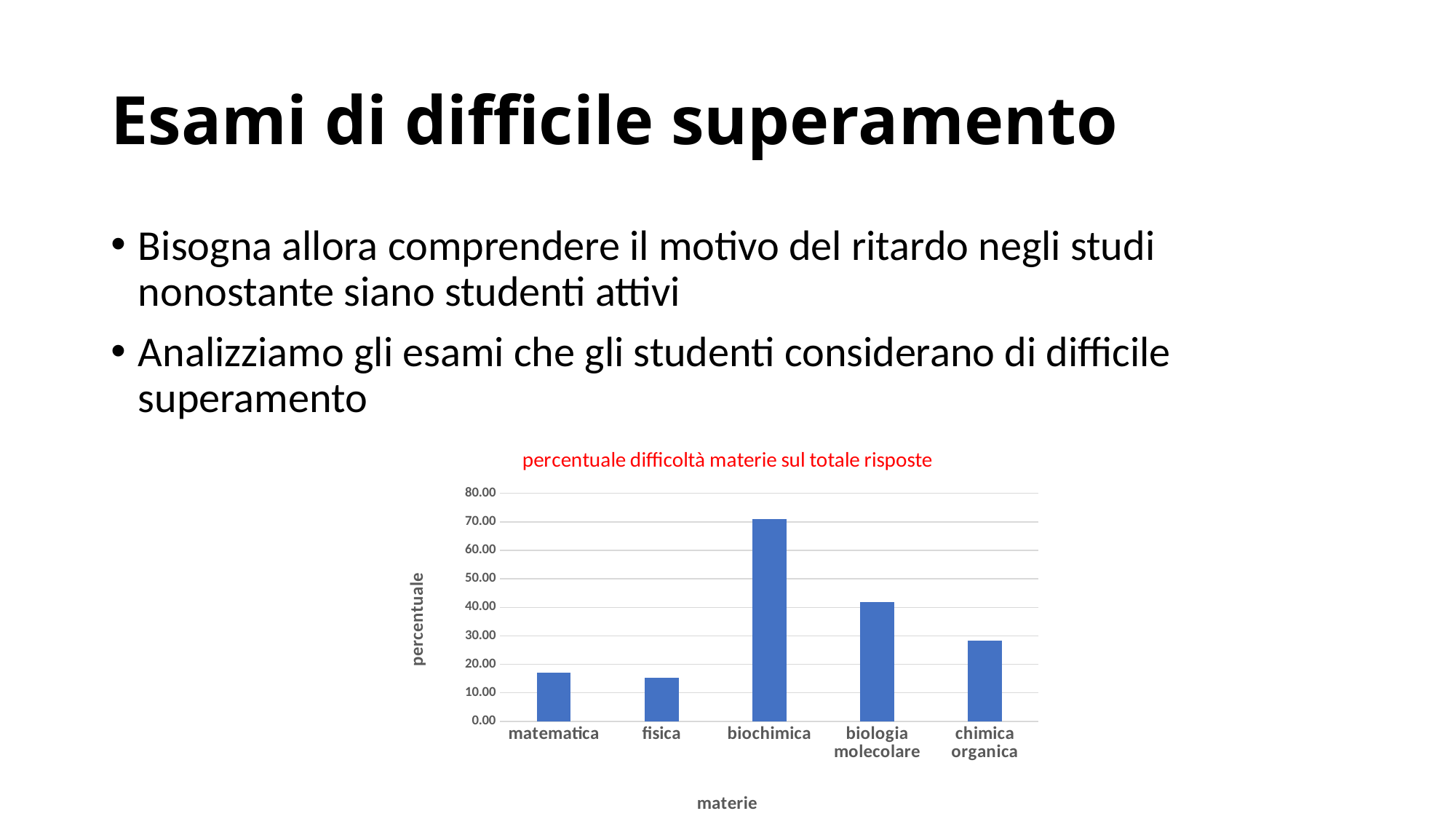
How many subjects (materie) are plotted on the chart? 5 Is the value for fisica greater or less than 20.00? less Is the value for chimica organica greater or less than 20.00? greater Is the value for biochimica greater or less than 60.00? greater What is the label of the vertical axis of the chart? percentuale Which subject has the highest percentage? biochimica What is the title of the chart? percentuale difficoltà materie sul totale risposte What kind of chart is shown on the slide? bar chart Which is larger, the value for biochimica or the value for matematica? biochimica Which is larger, the value for biologia molecolare or the value for chimica organica? biologia molecolare